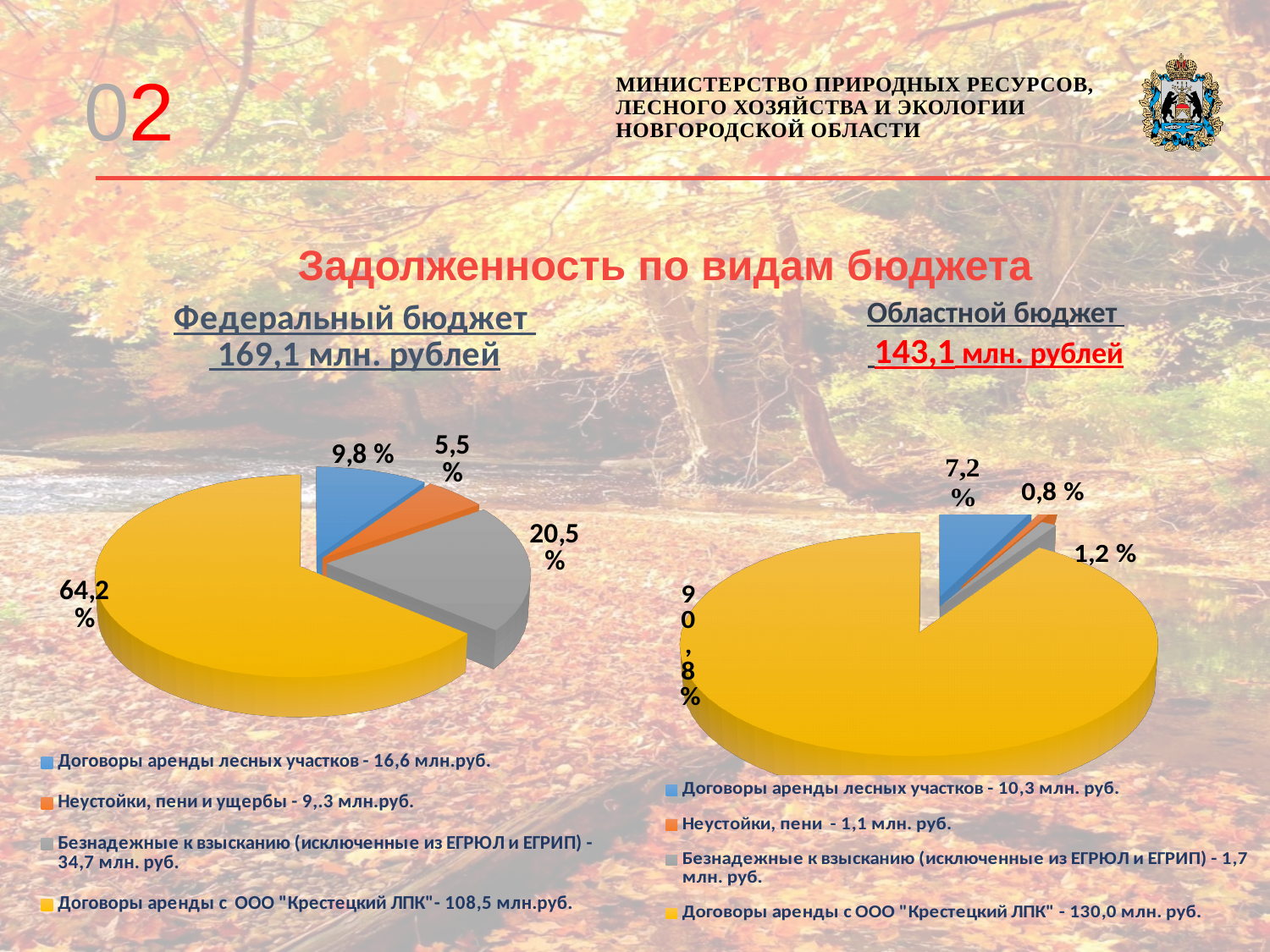
In the Федеральный бюджет chart legend, what amount is given for Договоры аренды лесных участков? 16,6 млн.руб. In the Федеральный бюджет pie chart, which category has the smallest share? Неустойки, пени и ущербы In the Областной бюджет pie chart, which category has the largest share? Договоры аренды с ООО "Крестецкий ЛПК" In the Федеральный бюджет pie chart, what share is shown for Безнадежные к взысканию (исключенные из ЕГРЮЛ и ЕГРИП)? 20,5 % In the Областной бюджет pie chart, what share is shown for Договоры аренды лесных участков? 7,2 % In the Областной бюджет pie chart, which share is larger: Неустойки, пени or Безнадежные к взысканию? Безнадежные к взысканию What total amount is stated in the title of the Федеральный бюджет chart? 169,1 млн. рублей In the Областной бюджет chart legend, what amount is given for Договоры аренды с ООО "Крестецкий ЛПК"? 130,0 млн. руб. What is the difference in percentage points between the Крестецкий ЛПК share in the Областной бюджет chart and in the Федеральный бюджет chart? 26,6 How many slices does the Областной бюджет pie chart have? 4 In the Федеральный бюджет pie chart, what share is shown for Договоры аренды с ООО "Крестецкий ЛПК"? 64,2 % What type of chart is used on the slide for the Федеральный бюджет data? Pie chart